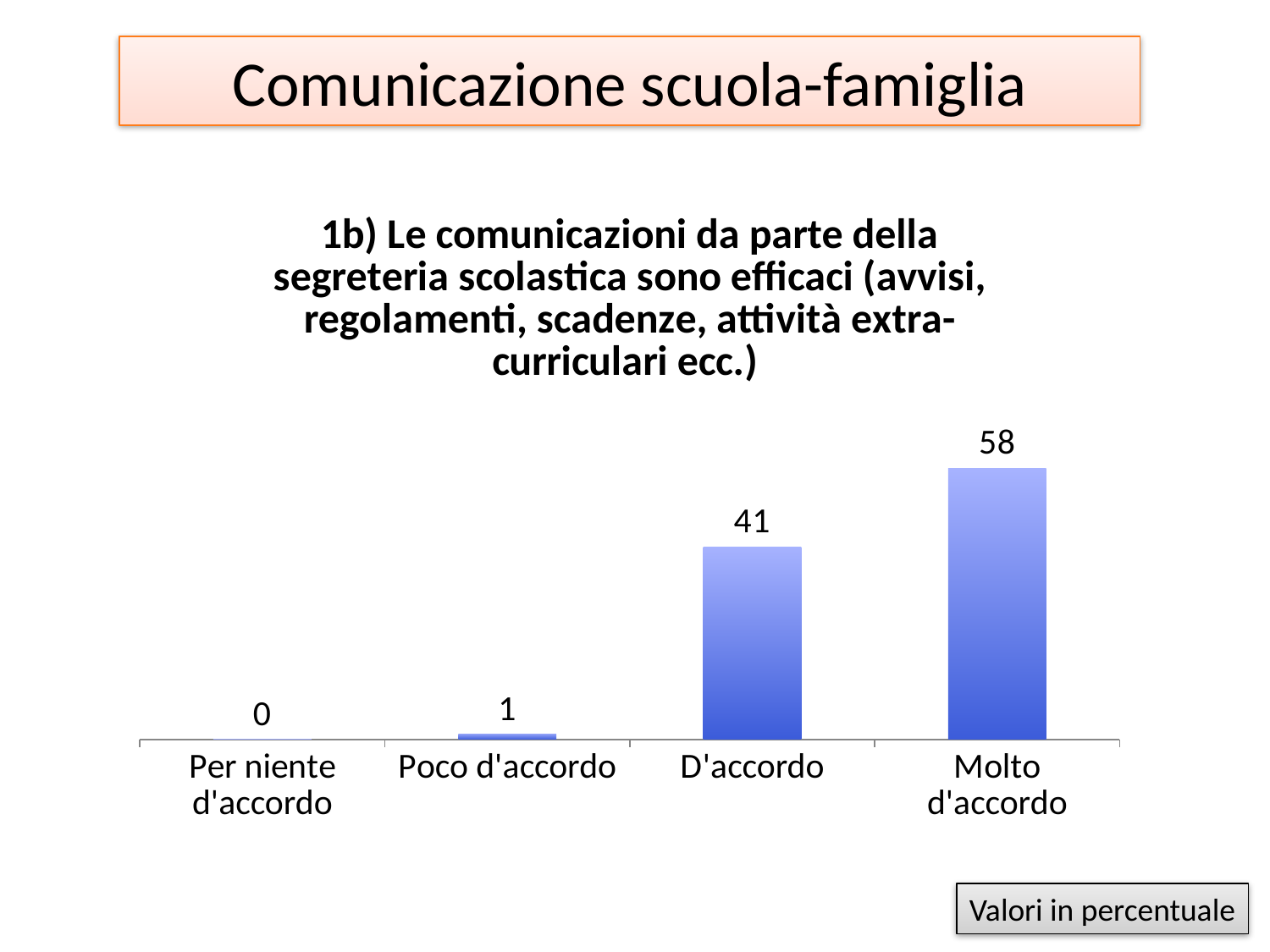
What is the value for "Poco d'accordo"? 1 Which category has the highest value? Molto d'accordo What kind of chart is shown on the slide? Bar chart What is the value for "Molto d'accordo"? 58 Which category has the lowest value? Per niente d'accordo What is the difference between the values for "Molto d'accordo" and "D'accordo"? 17 Do the values rise or fall from left to right along the x axis? Rise Which is larger, the value for "D'accordo" or the value for "Poco d'accordo"? D'accordo What is the value for "Per niente d'accordo"? 0 What is the value for "D'accordo"? 41 According to the note on the slide, in what unit are the values expressed? Percentuale (percentage) How many categories are shown on the x axis? 4